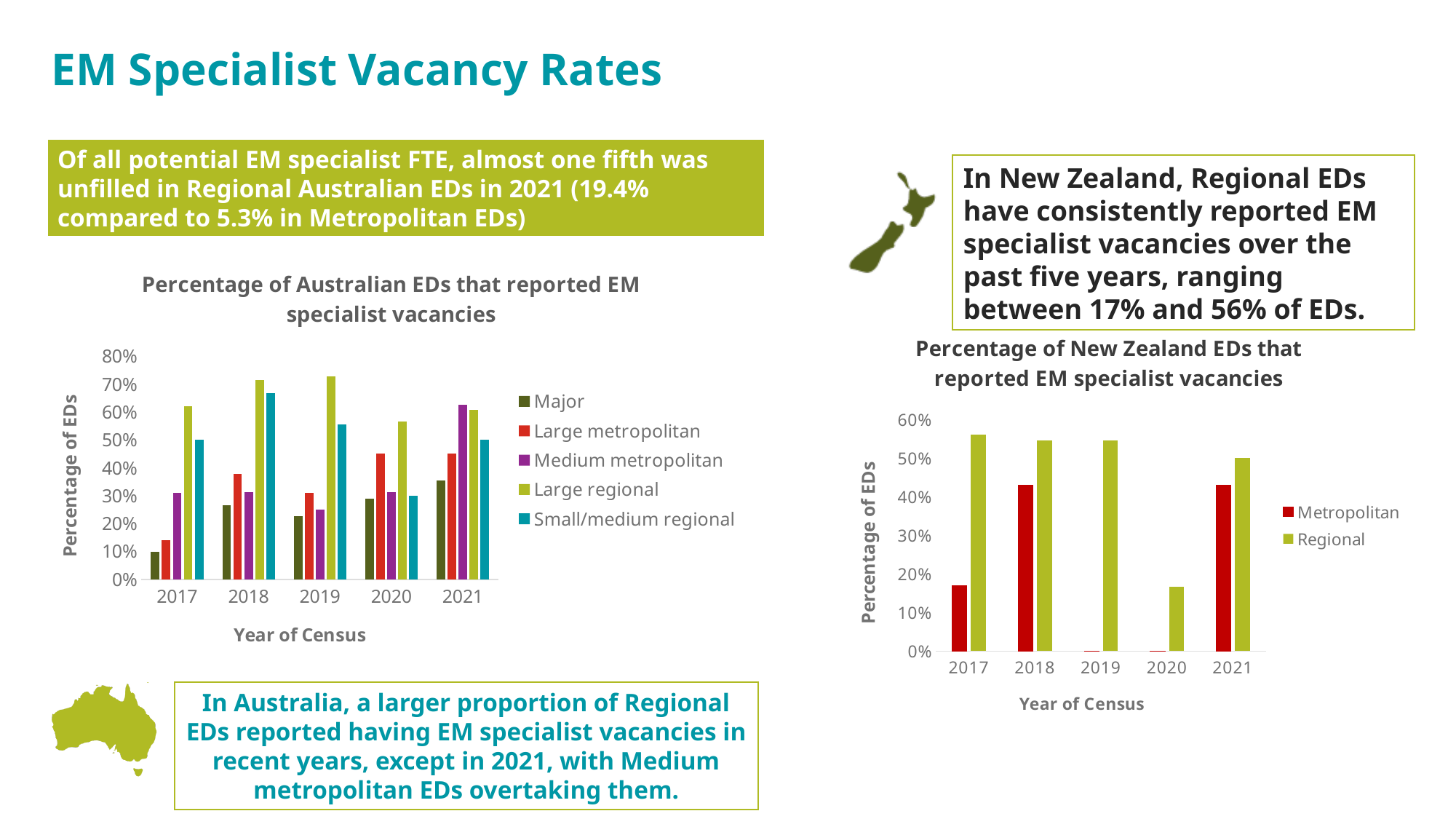
In the 'Percentage of Australian EDs that reported EM specialist vacancies' chart, is the Major value for 2017 greater or less than 20%? less What kind of chart is the 'Percentage of Australian EDs that reported EM specialist vacancies' chart? Bar chart In the 'Percentage of New Zealand EDs that reported EM specialist vacancies' chart, is the Metropolitan value for 2018 greater or less than 40%? greater How many series does the legend of the 'Percentage of Australian EDs that reported EM specialist vacancies' chart list? 5 In the 'Percentage of New Zealand EDs that reported EM specialist vacancies' chart, which year has the lowest Regional value? 2020 In the 'Percentage of New Zealand EDs that reported EM specialist vacancies' chart, is the Regional value for 2020 greater or less than 20%? less In the 'Percentage of New Zealand EDs that reported EM specialist vacancies' chart, which is larger in 2017, Metropolitan or Regional? Regional In the 'Percentage of Australian EDs that reported EM specialist vacancies' chart, which series has the highest value in 2019? Large regional How many census years are shown on the x axis of the 'Percentage of New Zealand EDs that reported EM specialist vacancies' chart? 5 In the 'Percentage of Australian EDs that reported EM specialist vacancies' chart, which series has the lowest value in 2017? Major In the 'Percentage of Australian EDs that reported EM specialist vacancies' chart, which is larger in 2020, Large metropolitan or Major? Large metropolitan How many series does the legend of the 'Percentage of New Zealand EDs that reported EM specialist vacancies' chart list? 2